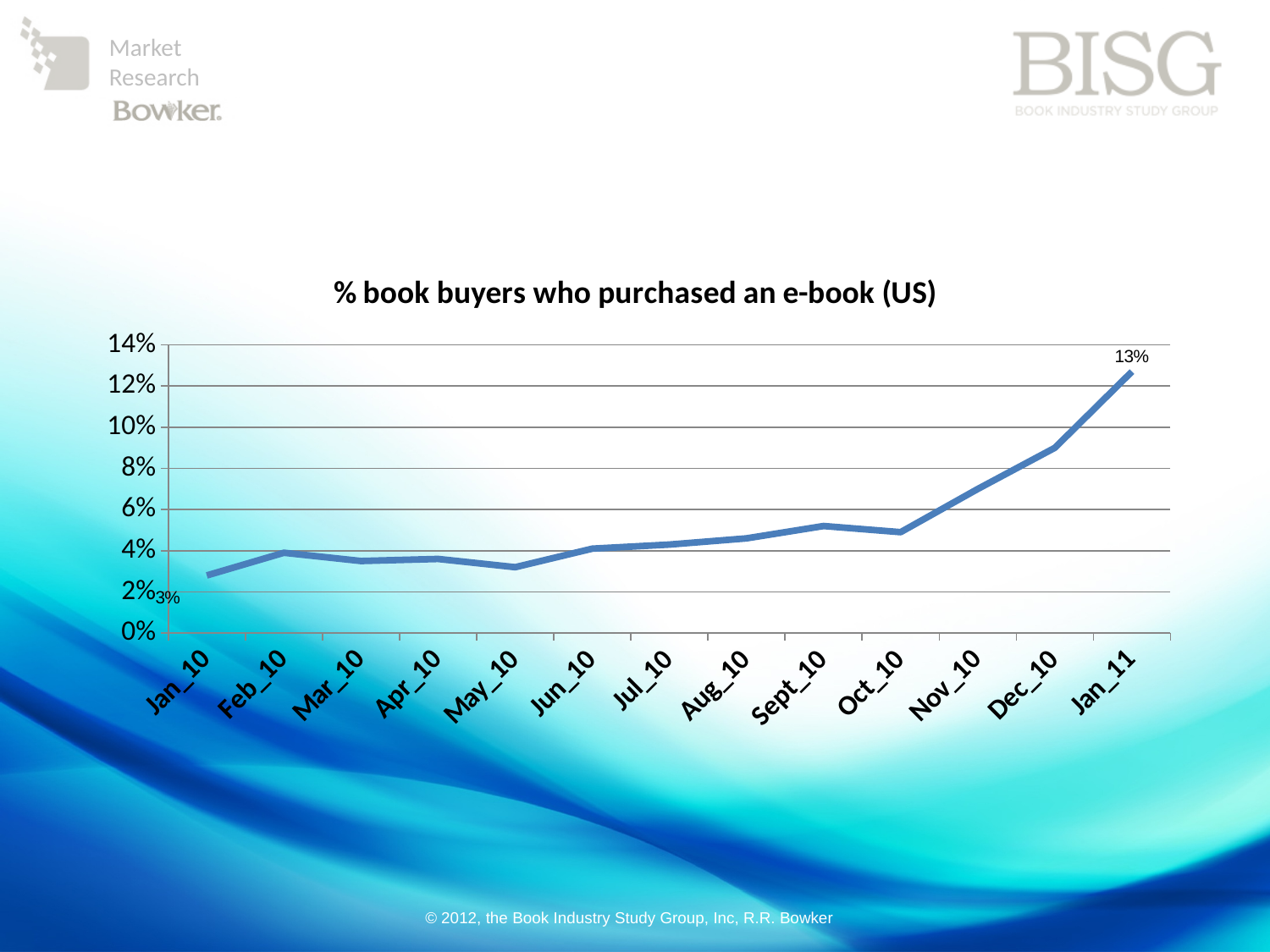
What kind of chart is shown? Line chart Do the values generally rise or fall from Jan_10 to Jan_11? Rise What is the difference between the values for Jan_11 and Jan_10? 10% Which month has the highest value? Jan_11 What is the title of the chart? % book buyers who purchased an e-book (US) What is the value for Jan_11? 13% Is the value for Dec_10 greater or less than 8%? greater Is the value for Jul_10 greater or less than 6%? less Which month has the lowest value? Jan_10 What is the value for Jan_10? 3% Which is larger, the value for Dec_10 or the value for Oct_10? Dec_10 How many months are plotted on the x axis? 13